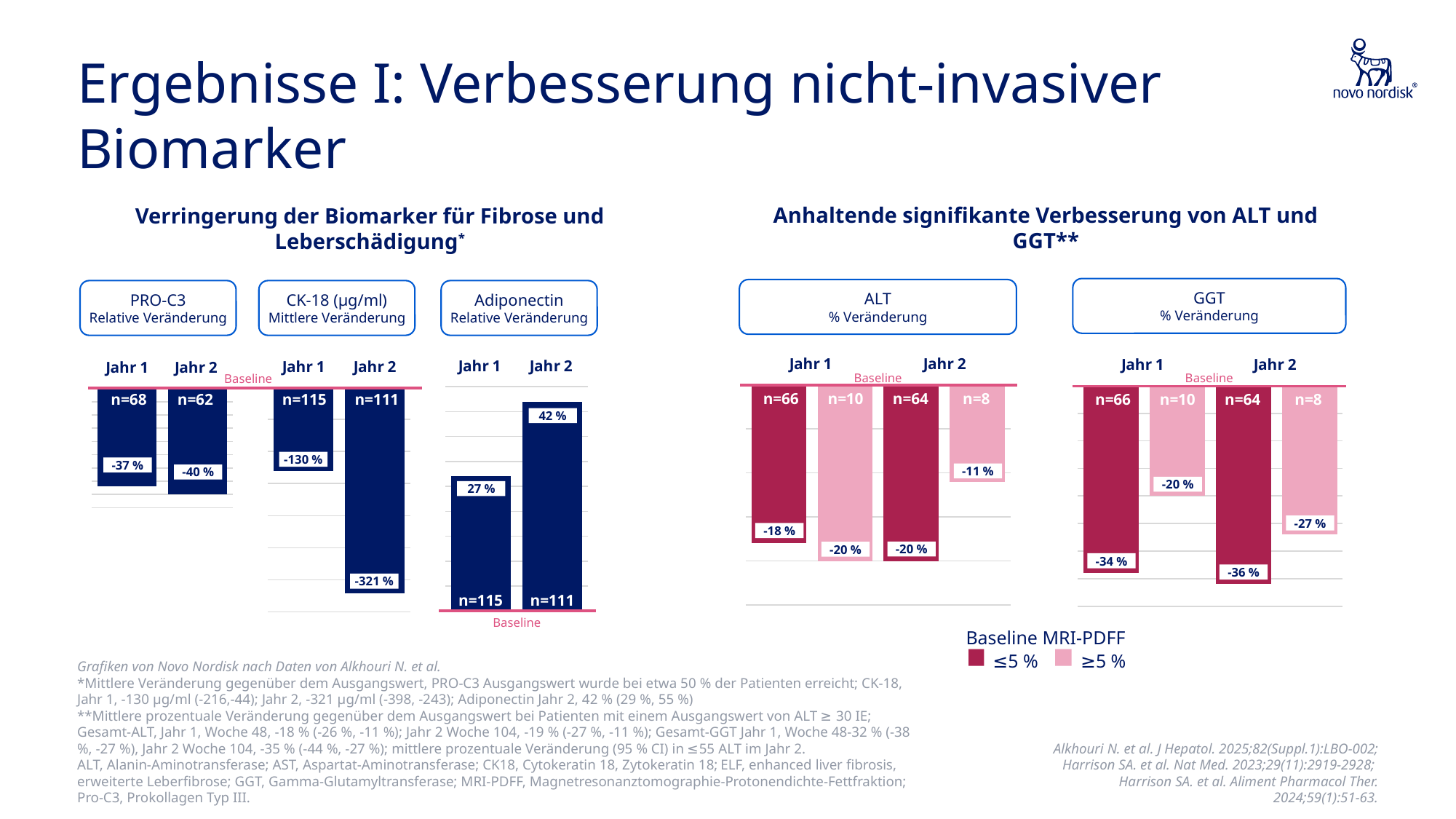
How many series does the Baseline MRI-PDFF legend list for the ALT and GGT charts? 2 In the CK-18 chart, which year shows the larger decrease, Jahr 1 or Jahr 2? Jahr 2 In the PRO-C3 chart, what is the relative change shown for Jahr 2? -40 % What type of chart is used to show the ALT % change? Bar chart In the Adiponectin chart, what is the value shown for Jahr 2? 42 % In the GGT chart, which bar shows the largest decrease? Jahr 2, ≤5 % group (-36 %) In the Adiponectin chart, what is the difference between the Jahr 2 and Jahr 1 values? 15 % In the GGT chart, what is the % change for Jahr 1 in the ≤5 % baseline MRI-PDFF group? -34 % In the CK-18 chart, what is the value shown for Jahr 1? -130 % In the ALT chart, what is the % change for Jahr 2 in the ≥5 % baseline MRI-PDFF group? -11 % In the PRO-C3 chart, how many bars are shown? 2 In the GGT chart, what is the n for the ≥5 % group in Jahr 2? n=8